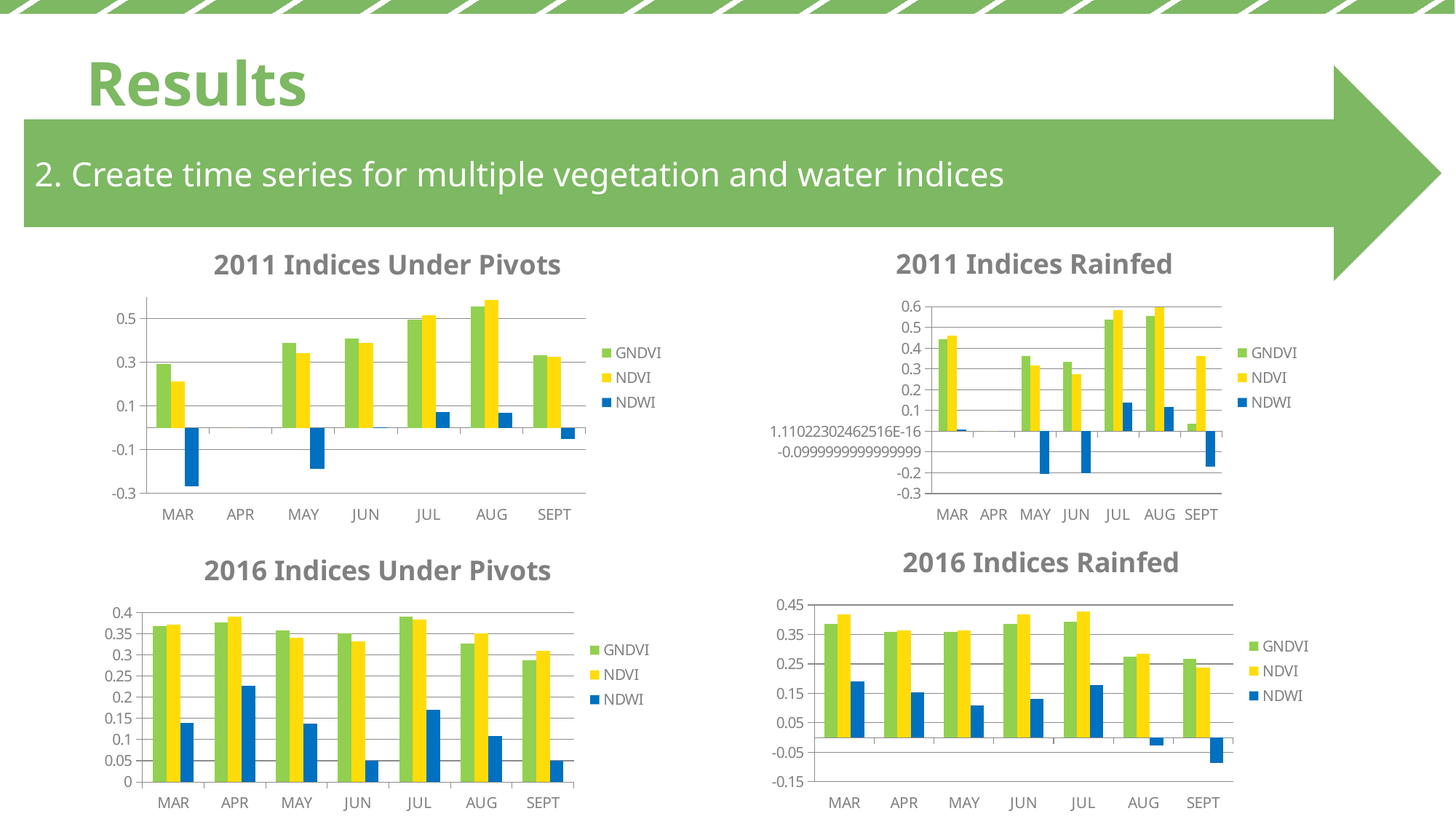
In the '2016 Indices Rainfed' chart, which month has the lowest NDWI value? SEPT In the '2011 Indices Under Pivots' chart, is the NDWI value for MAR greater or less than -0.1? less In the '2016 Indices Under Pivots' chart, which month has the highest NDWI value? APR In the '2011 Indices Rainfed' chart, is the GNDVI value for SEPT greater or less than 0.1? less In the '2016 Indices Rainfed' chart, which is larger: the NDWI value for MAR or the NDWI value for AUG? MAR In the '2011 Indices Under Pivots' chart, is the NDVI value for AUG greater or less than 0.5? greater In the '2011 Indices Rainfed' chart, which month has the highest NDVI value? AUG In the '2011 Indices Under Pivots' chart, which month has the highest NDVI value? AUG In the '2011 Indices Under Pivots' chart, which month has no bars plotted? APR How many series does the legend of the '2016 Indices Rainfed' chart list? 3